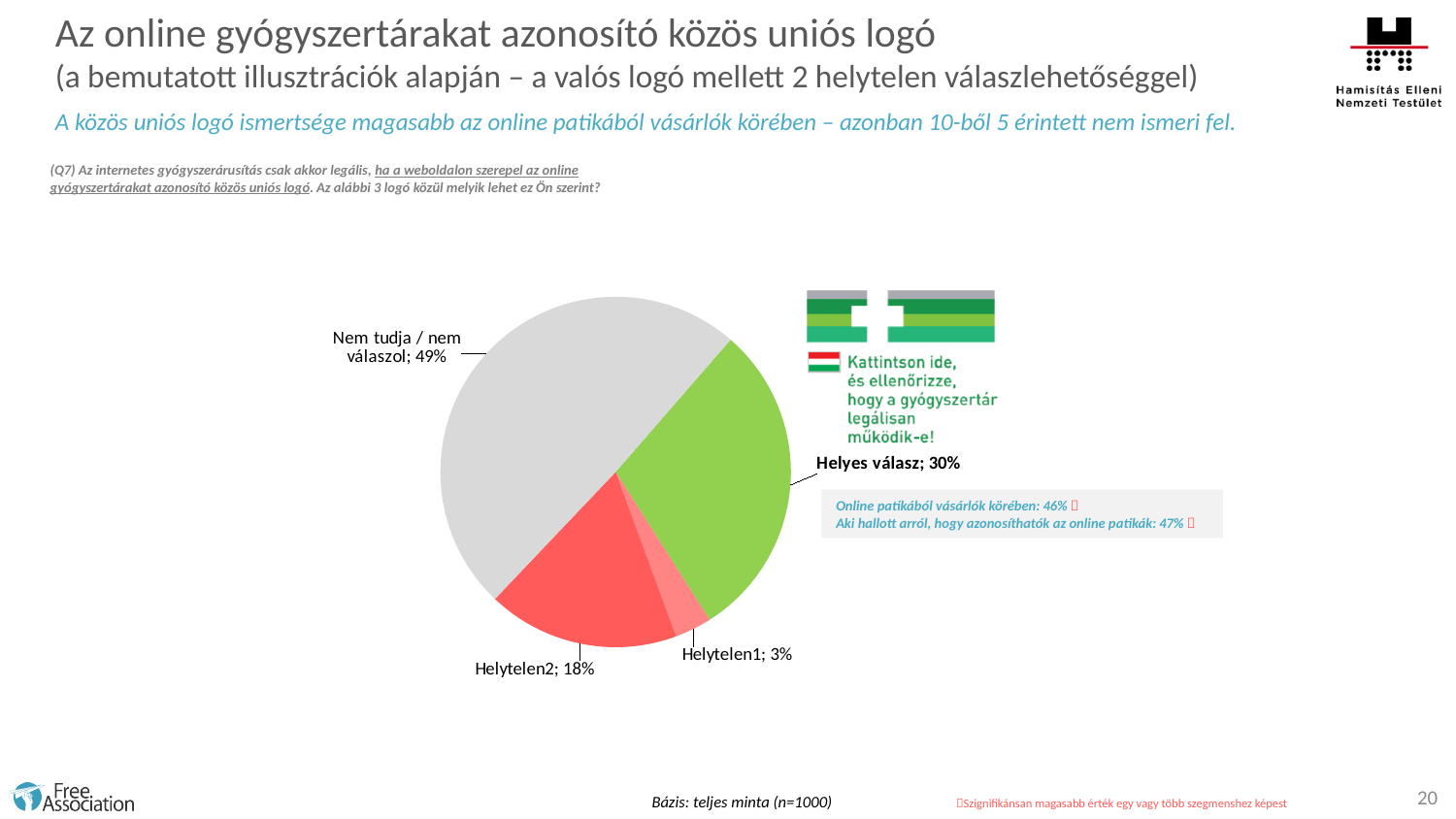
Which is larger, the share for "Helytelen2" or the share for "Helyes válasz"? Helyes válasz What is the value for "Helytelen2"? 18% What kind of chart is shown on the slide? pie chart What is the combined share of the two incorrect answers, "Helytelen1" and "Helytelen2"? 21% How many slices does the pie chart have? 4 What colour is the "Helyes válasz" slice of the pie? green What is the difference between the "Nem tudja / nem válaszol" share and the "Helyes válasz" share? 19 percentage points What is the value for "Helytelen1"? 3% Which slice of the pie is the largest? Nem tudja / nem válaszol What share of the pie is labelled "Helyes válasz"? 30% Which slice of the pie is the smallest? Helytelen1 What is the value for "Nem tudja / nem válaszol"? 49%